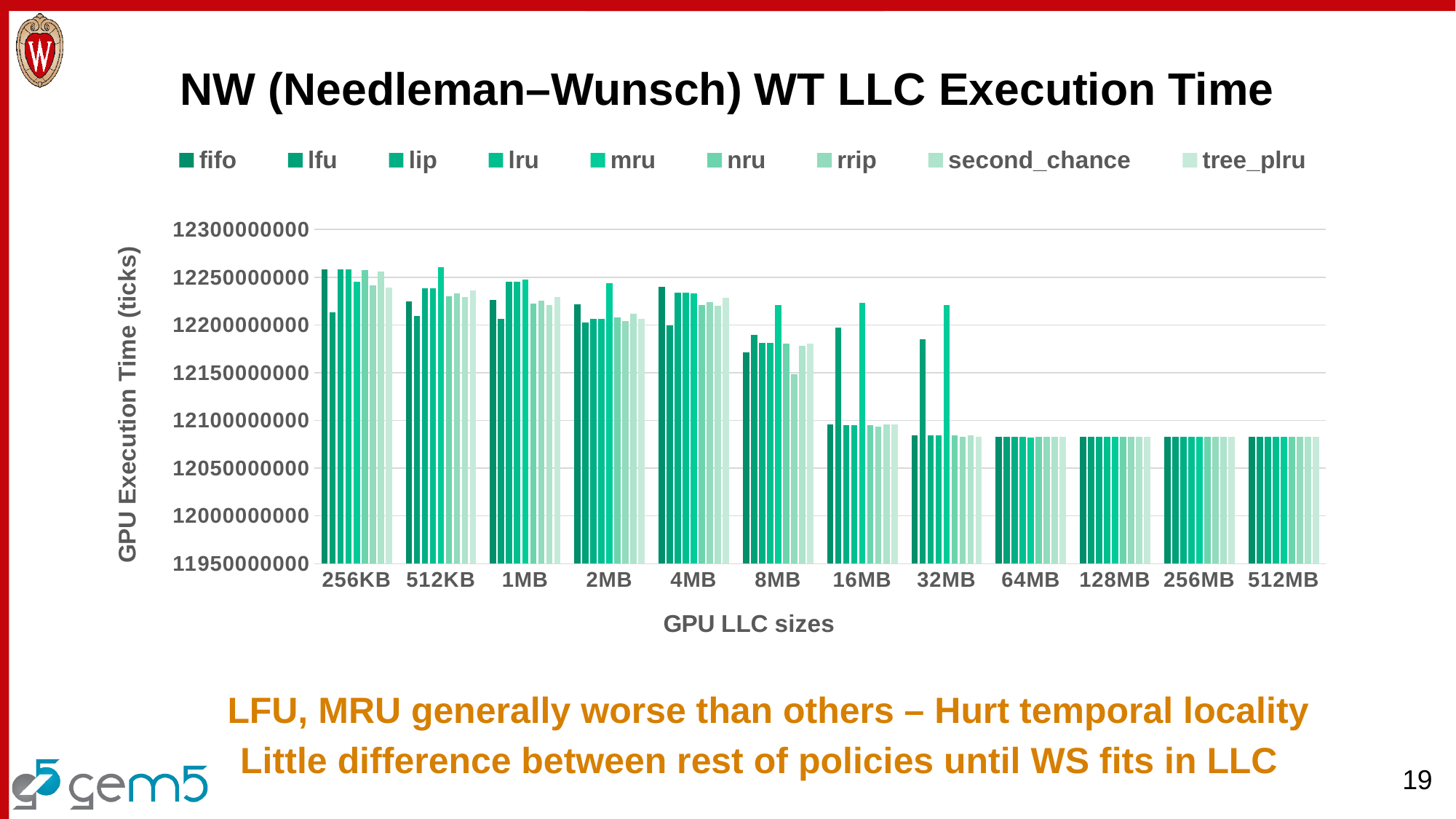
What kind of chart is shown on the slide? bar chart Is the value for mru at 16MB greater or less than 12200000000? greater Which series has the highest value at 32MB? mru How many GPU LLC sizes are shown along the x axis? 12 Is the value for fifo at 64MB greater or less than 12100000000? less Is the value for fifo at 8MB greater or less than 12150000000? greater What is the label of the y axis? GPU Execution Time (ticks) At 16MB, which is larger: the value for mru or the value for fifo? mru Do the fifo values generally rise or fall as the GPU LLC size increases along the x axis? fall What is the title of the chart? NW (Needleman–Wunsch) WT LLC Execution Time How many series does the legend list? 9